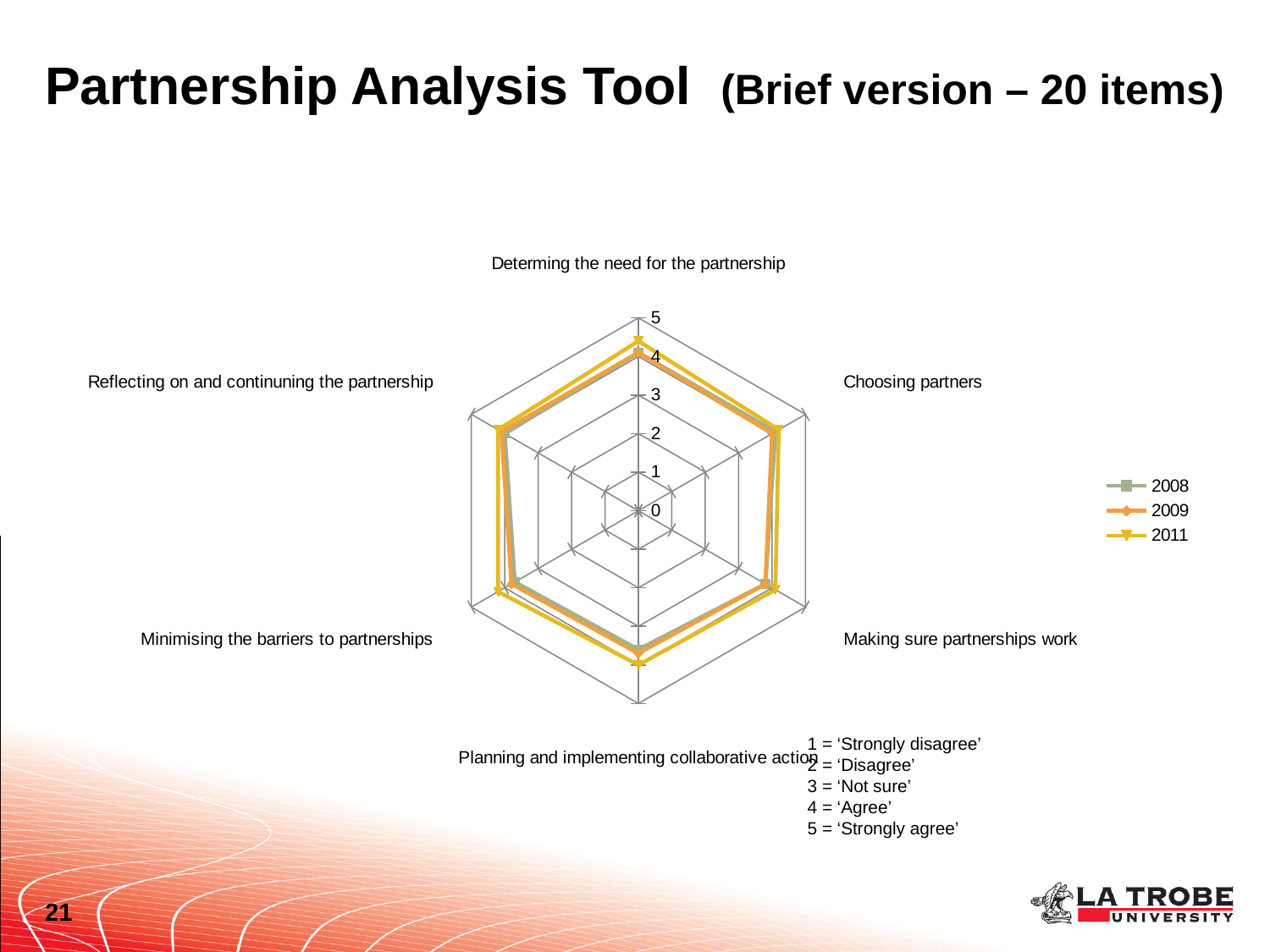
Is the 2008 value for 'Choosing partners' greater or less than 5? less What kind of chart is shown on the slide? Radar chart Is the 2011 value for 'Determing the need for the partnership' greater or less than 3? greater How many series does the legend list? 3 According to the key on the slide, what response does a value of 4 represent? 'Agree' Is the 2009 value for 'Making sure partnerships work' greater or less than 3? greater Which years are listed in the chart legend? 2008, 2009, 2011 How many categories (axes) does the radar chart have? 6 What is the maximum value shown on the chart's axis scale? 5